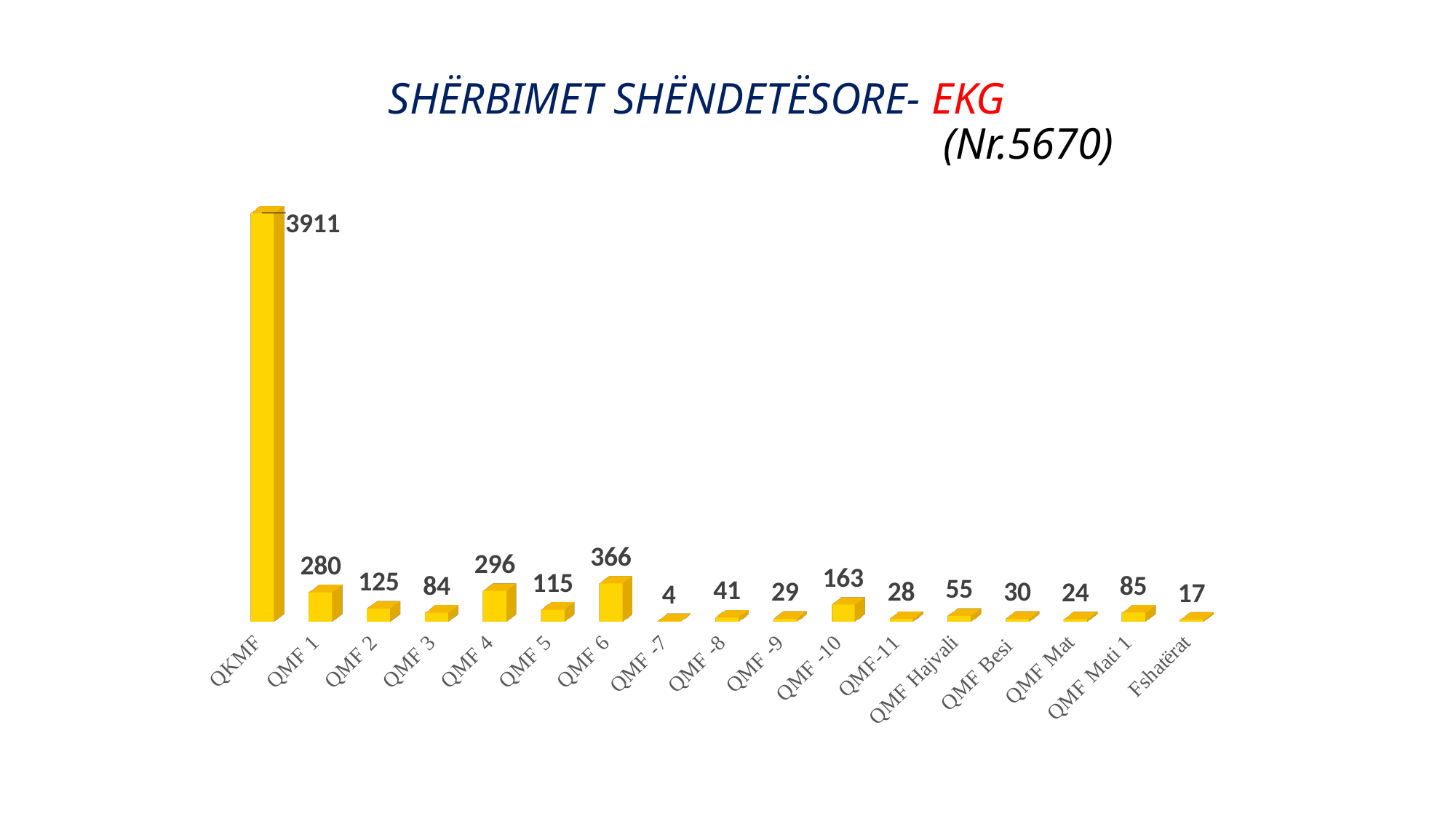
What total number is shown in parentheses in the chart title? Nr.5670 Which category has the highest value? QKMF Which category has the lowest value? QMF -7 What is the value for QMF 6? 366 What kind of chart is shown on the slide? Bar chart What is the value for QKMF? 3911 How many categories are shown on the x axis? 17 What is the value for QMF Hajvali? 55 What is the difference between the values for QMF 6 and QMF 4? 70 What is the difference between the values for QMF Mati 1 and QMF Mat? 61 Which is larger, the value for QMF 1 or the value for QMF -10? QMF 1 What is the value for Fshatërat? 17